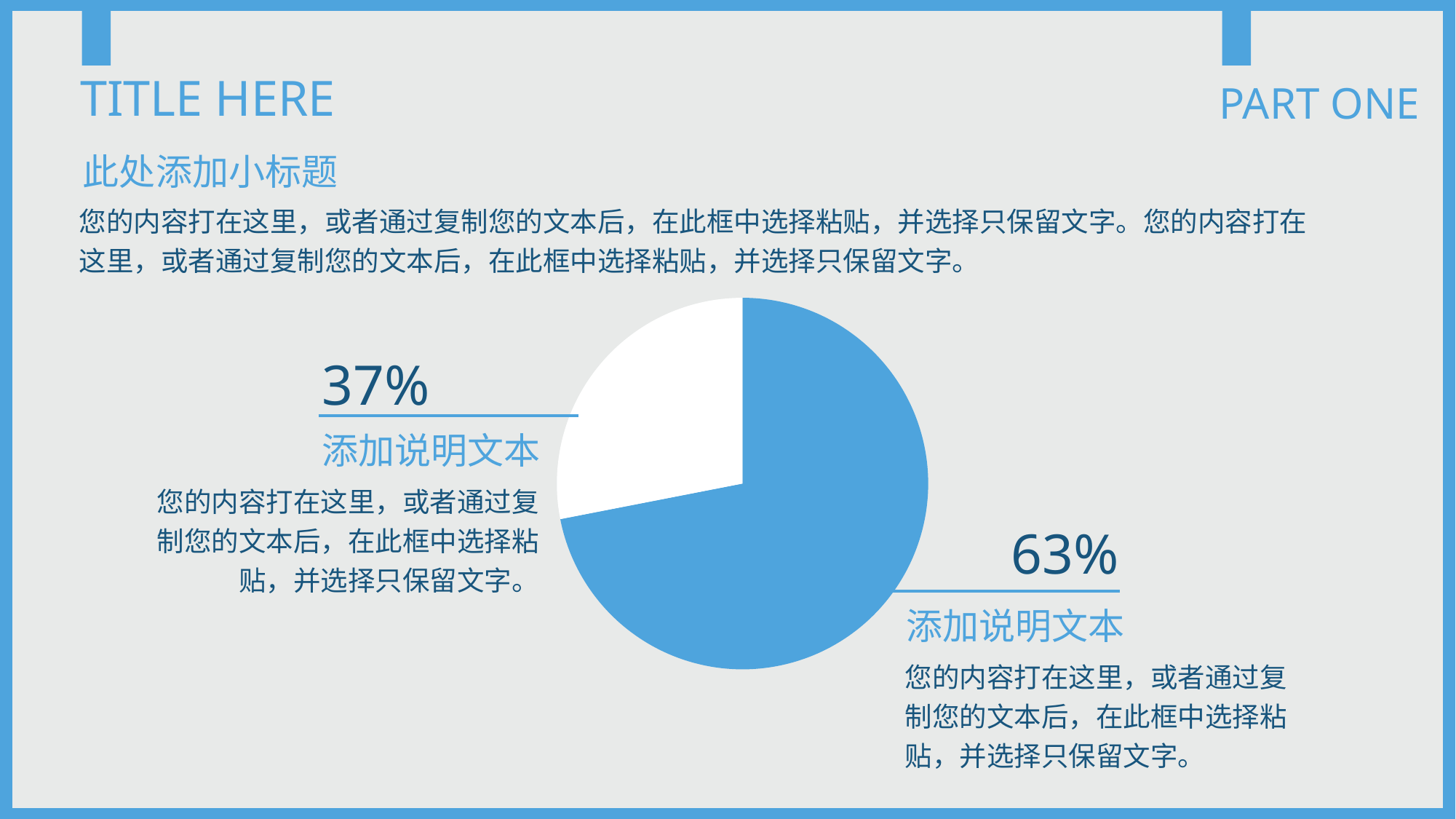
Which is larger, the blue slice or the white slice of the pie chart? the blue slice What percentage is shown for the blue slice of the pie chart? 63% What colour is the larger slice of the pie chart? blue Which slice of the pie chart is the smallest? the white slice (37%) What percentage is shown for the white slice of the pie chart? 37% What is the difference between the two percentages shown on the pie chart? 26 percentage points What do the two percentages on the pie chart add up to? 100% What share of the pie does the white slice represent? 37% What kind of chart is shown on the slide? pie chart Is the blue slice of the pie chart greater or less than 50%? greater How many slices does the pie chart have? 2 Which slice of the pie chart is the largest? the blue slice (63%)